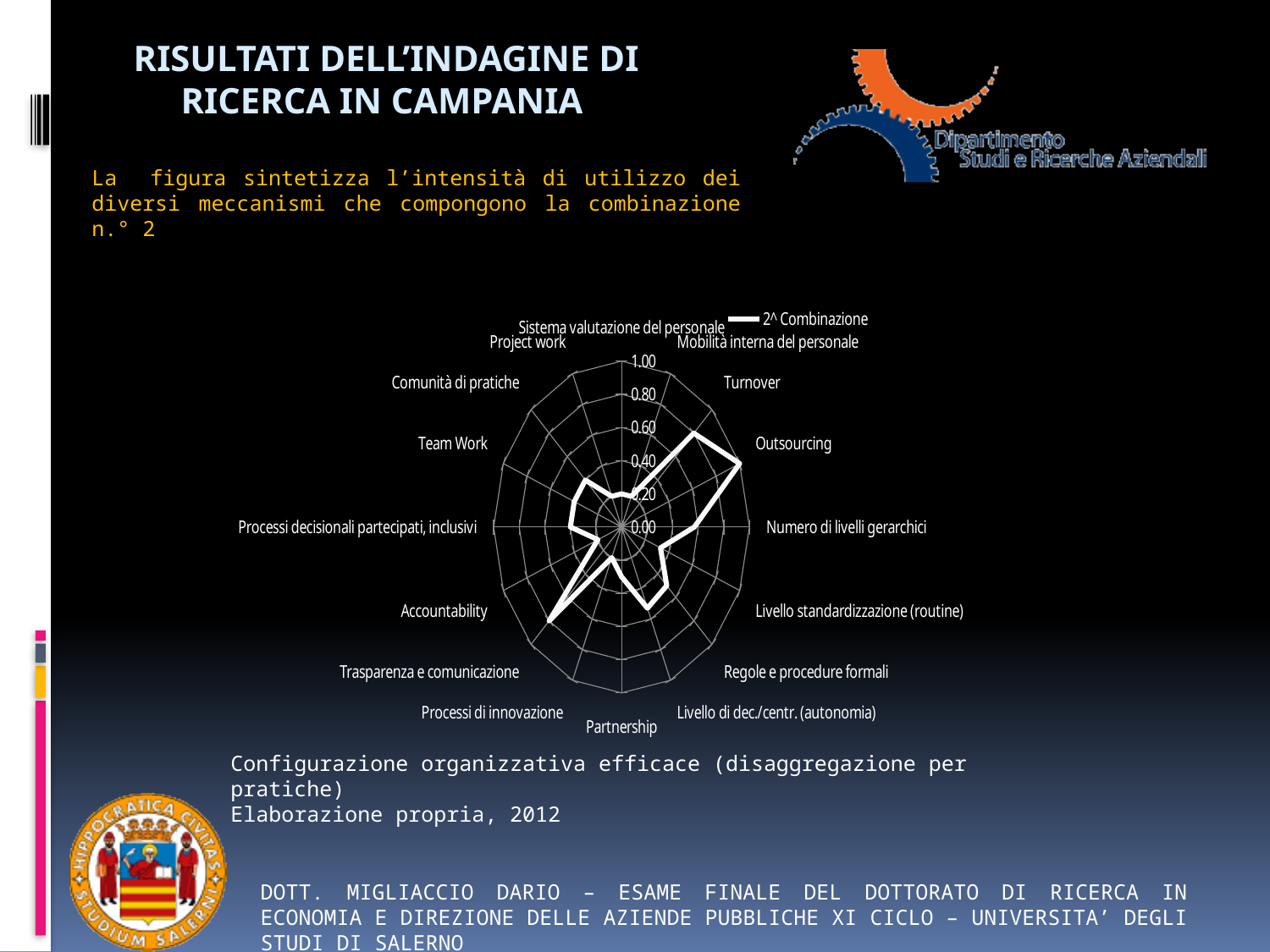
Which has the larger value, Outsourcing or Numero di livelli gerarchici? Outsourcing What is the maximum value shown on the chart's radial axis? 1.00 What kind of chart is shown on the slide? Radar chart Is the value for Outsourcing greater or less than 0.60? greater What is the name of the series shown in the chart legend? 2^ Combinazione Is the value for Sistema valutazione del personale greater or less than 0.40? less How many series does the legend of the chart list? 1 How many categories (axes) does the radar chart have? 16 Is the value for Accountability greater or less than 0.60? less Which has the larger value, Accountability or Team Work? Team Work